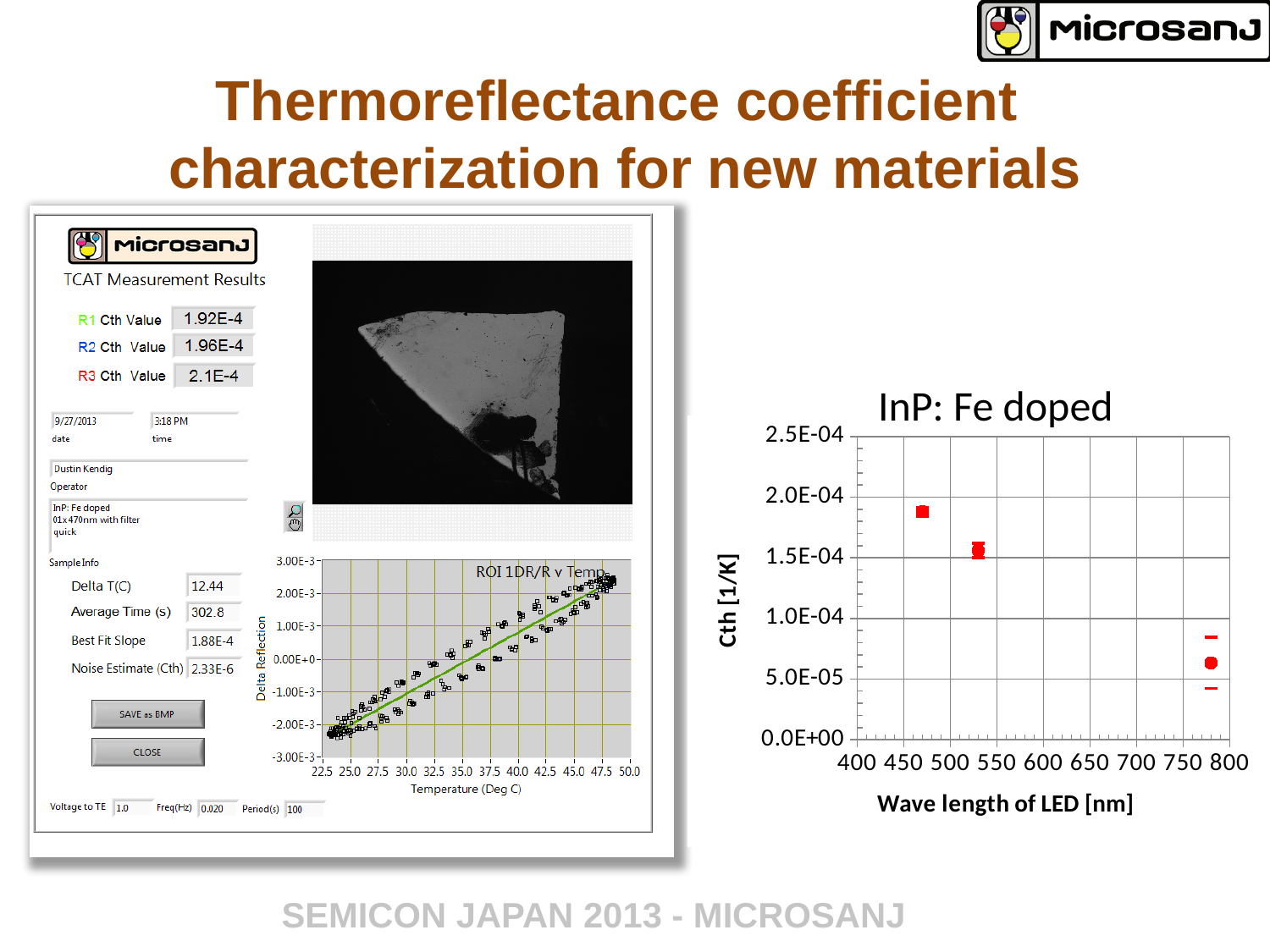
On the 'InP: Fe doped' chart, is the Cth value for the point near 530 nm greater or less than 2.0E-04? less On the 'InP: Fe doped' chart, is the Cth value for the point near 780 nm greater or less than 1.0E-04? less On the 'InP: Fe doped' chart, what is the label of the y axis? Cth [1/K] On the 'InP: Fe doped' chart, does Cth rise or fall as the LED wavelength increases? fall On the 'ROI 1DR/R v Temp' chart in the screenshot on the left, is the Delta Reflection at 25.0 Deg C greater or less than -1.00E-3? less On the 'InP: Fe doped' chart, what kind of chart is it? scatter chart On the 'InP: Fe doped' chart, what is the label of the x axis? Wave length of LED [nm] On the 'InP: Fe doped' chart, how many data points are plotted? 3 On the 'ROI 1DR/R v Temp' chart in the screenshot on the left, does Delta Reflection rise or fall as temperature increases? rise On the 'InP: Fe doped' chart, which point has the higher Cth: the one near 470 nm or the one near 780 nm? the one near 470 nm